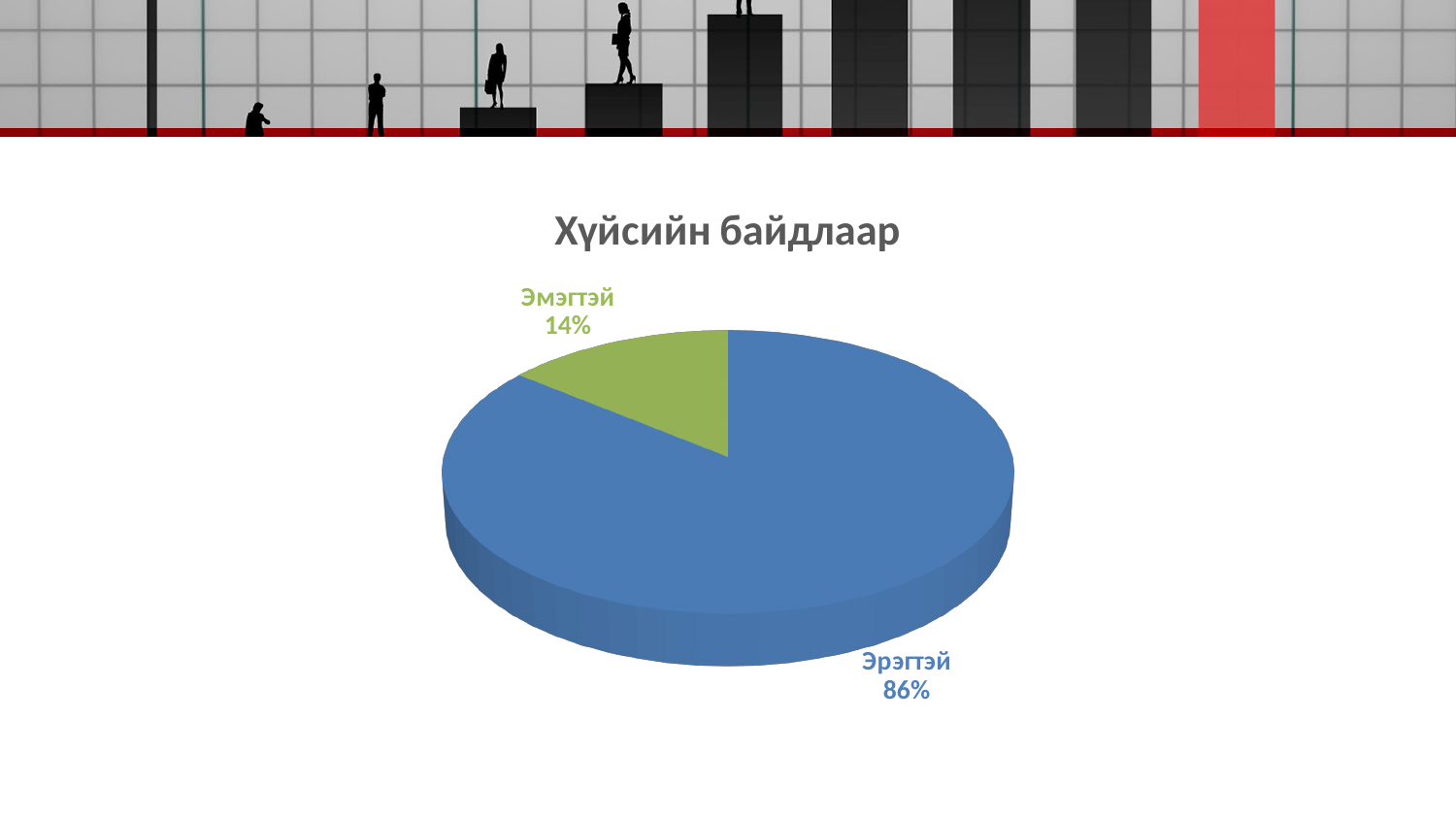
What share of the pie does Эрэгтэй have? 86% What is the title of the chart? Хүйсийн байдлаар Which category has the smallest slice of the pie? Эмэгтэй What colour is the slice for Эмэгтэй? Green What is the difference in percentage points between Эрэгтэй and Эмэгтэй? 72 Which category has the largest slice of the pie? Эрэгтэй How many categories are shown in the pie chart? 2 What kind of chart is shown on the slide? Pie chart Which is larger, the share for Эрэгтэй or the share for Эмэгтэй? Эрэгтэй What share of the pie does Эмэгтэй have? 14%